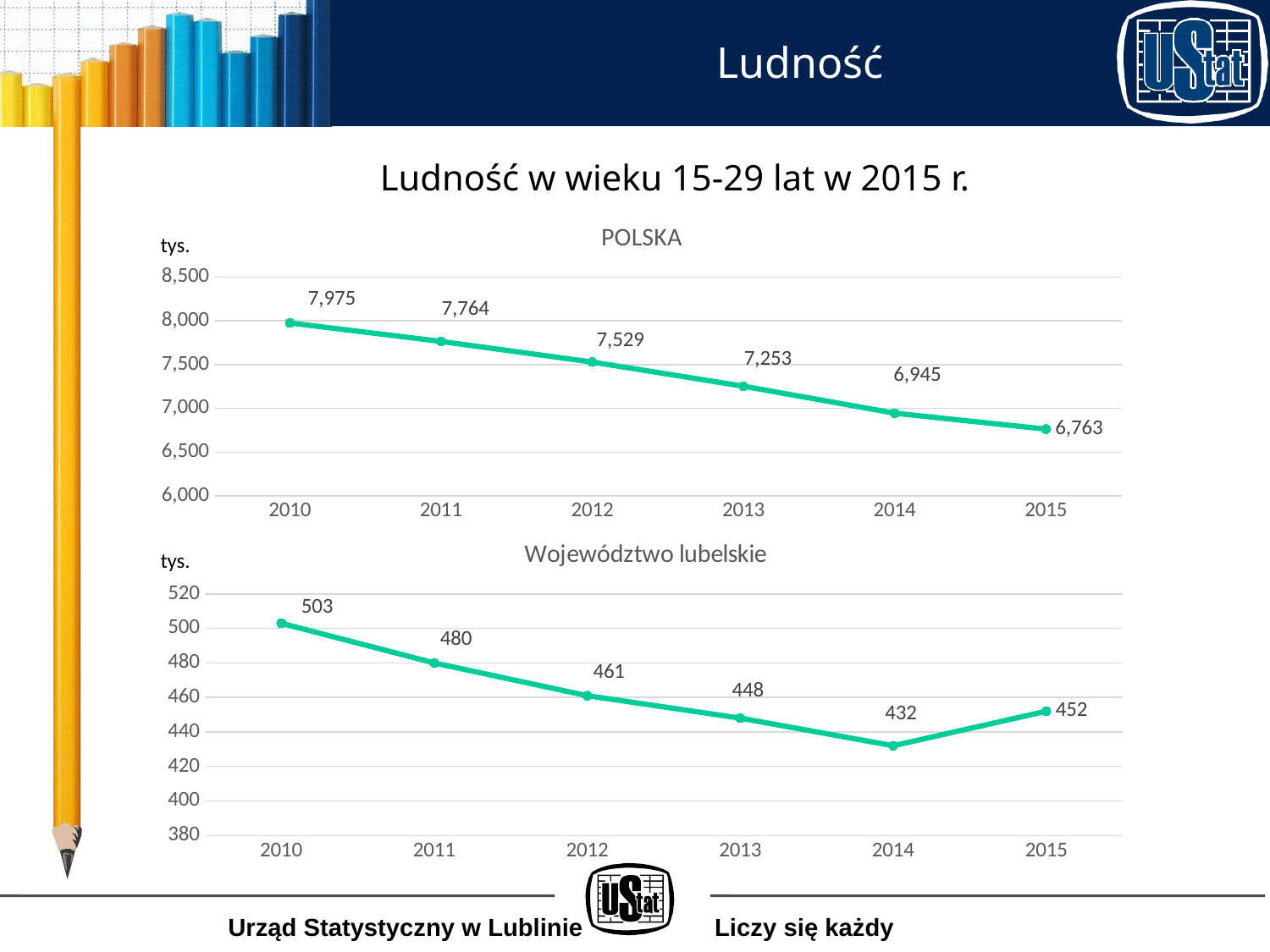
In the Województwo lubelskie chart, what is the value for 2014? 432 In the Województwo lubelskie chart, what is the difference between the 2013 and 2014 values? 16 What type of chart is the Województwo lubelskie chart? line chart In the POLSKA chart, what is the value for 2015? 6,763 In the Województwo lubelskie chart, which year has the lowest value? 2014 In the POLSKA chart, what is the value for 2010? 7,975 In the POLSKA chart, what is the difference between the 2010 and 2015 values? 1,212 In the Województwo lubelskie chart, which is larger, the value for 2012 or the value for 2015? 2012 In the POLSKA chart, how many data points are plotted? 6 In the POLSKA chart, do the values rise or fall from 2010 to 2015? fall In the Województwo lubelskie chart, which year has the highest value? 2010 In the POLSKA chart, which year has the lowest value? 2015